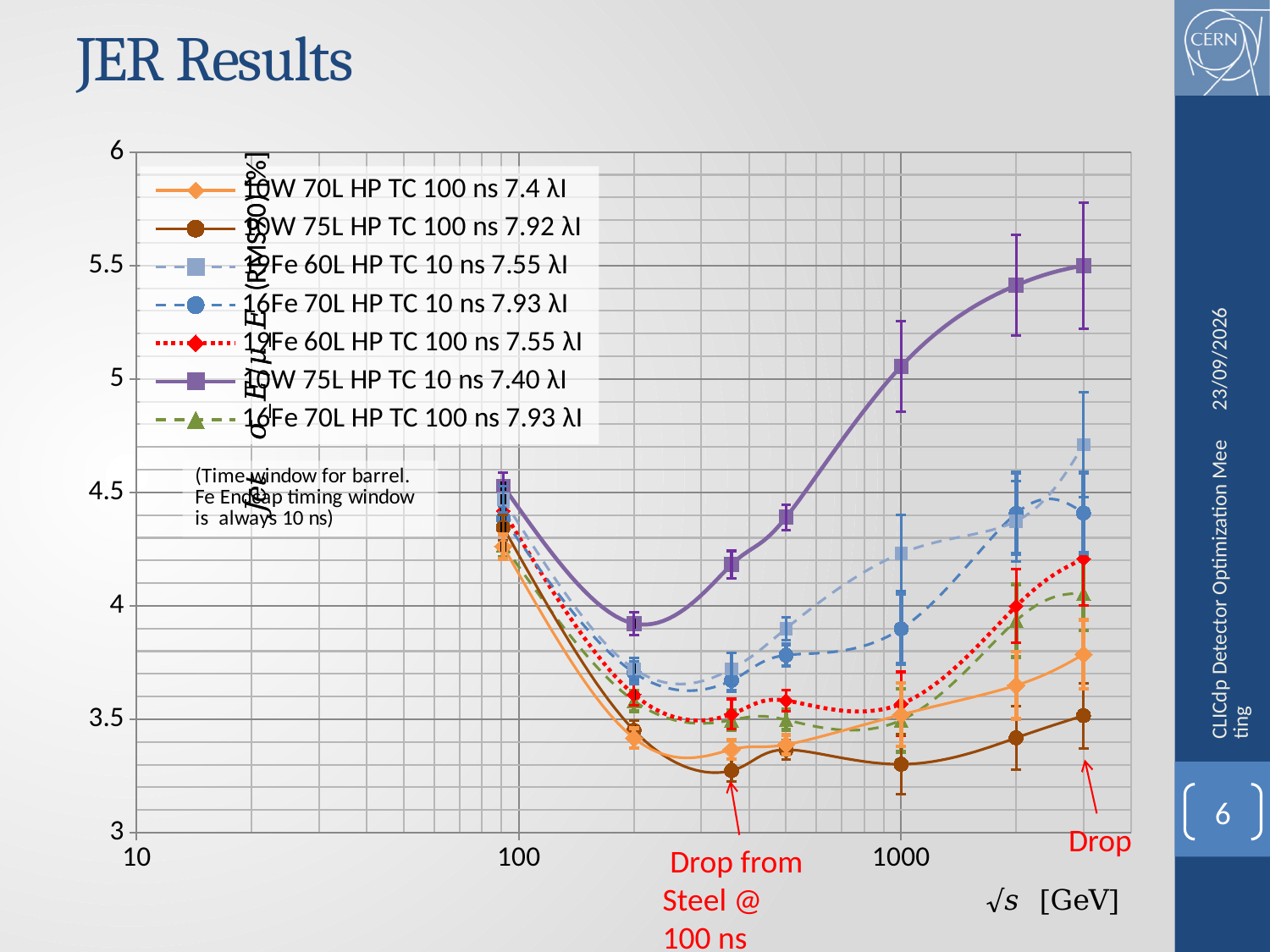
Is the value of the purple square-marker series at √s = 500 GeV greater or less than 4? greater At √s = 1000 GeV, which is larger: the purple square-marker series or the brown circle-marker series? the purple square-marker series Which series has the lowest value at √s = 1000 GeV? the brown solid line with circle markers (HP TC 100 ns 7.92 λI) Which series reaches the highest value at the right end of the x axis (around 3000 GeV)? the purple solid line with square markers (HP TC 10 ns 7.40 λI) How many series does the legend list? 7 What is the label of the x axis? √s [GeV] What kind of chart is shown on the slide? line chart Does the purple square-marker series rise or fall between √s = 200 GeV and √s = 3000 GeV? rise How many data points does each series have? 7 What is the title of the slide containing the chart? JER Results Is the value of the brown circle-marker series at √s = 1000 GeV greater or less than 3.5? less Is the value of the light blue dashed square-marker series at its rightmost point greater or less than 4.5? greater